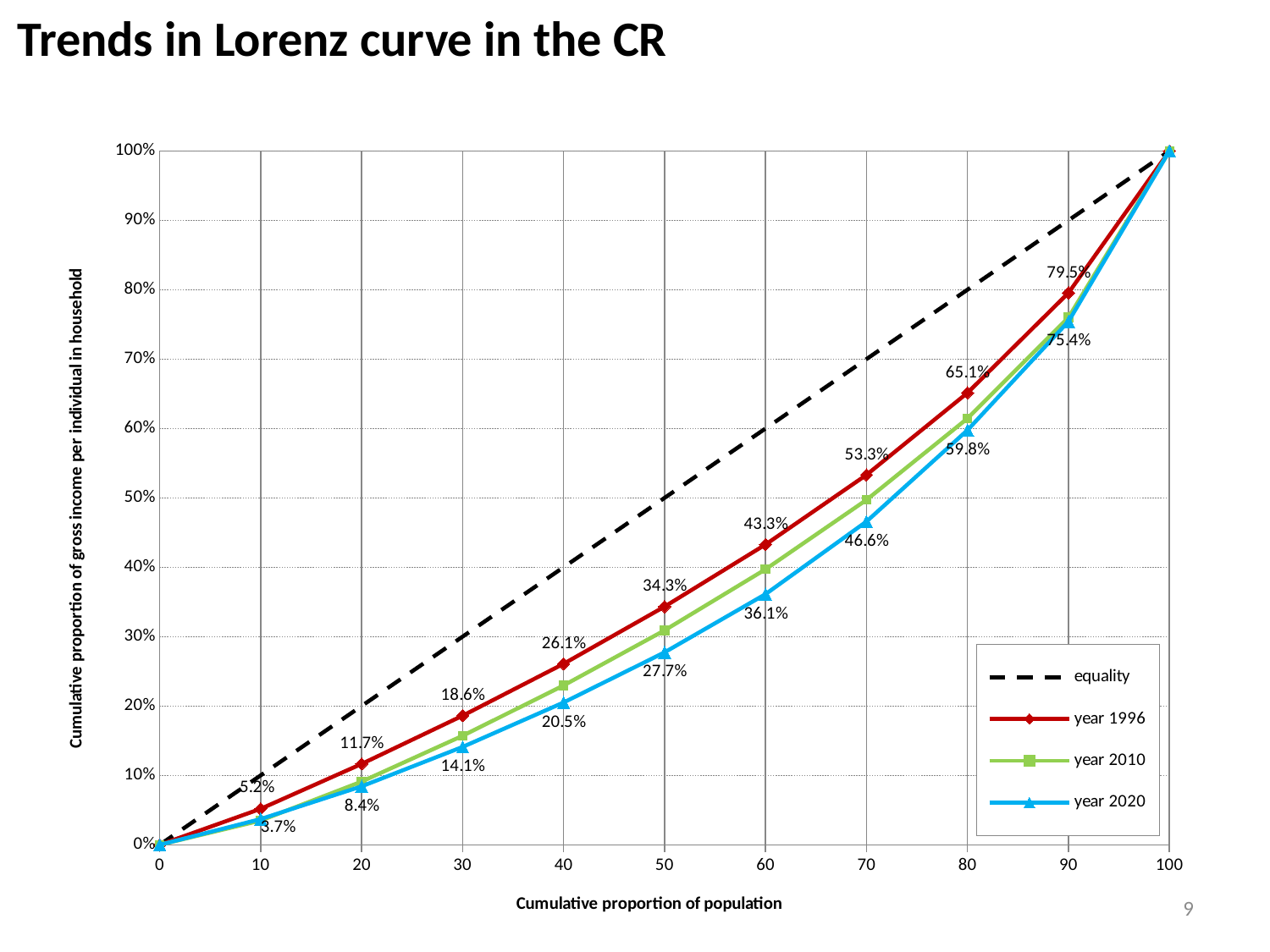
What is the title of the chart's x axis? Cumulative proportion of population What is the value for year 1996 at a cumulative proportion of population of 90? 79.5% What kind of chart is shown on the slide? line chart How many series does the legend list? 4 What is the value for year 1996 at a cumulative proportion of population of 50? 34.3% What is the value for year 2020 at a cumulative proportion of population of 10? 3.7% What is the difference between the year 1996 and year 2020 values at a cumulative proportion of population of 70? 6.7% Do the values for year 2020 rise or fall as the cumulative proportion of population increases? rise Is the value for year 2010 at a cumulative proportion of population of 80 greater or less than 60%? greater What is the value for year 2020 at a cumulative proportion of population of 80? 59.8% At a cumulative proportion of population of 40, which series has the larger value, year 1996 or year 2020? year 1996